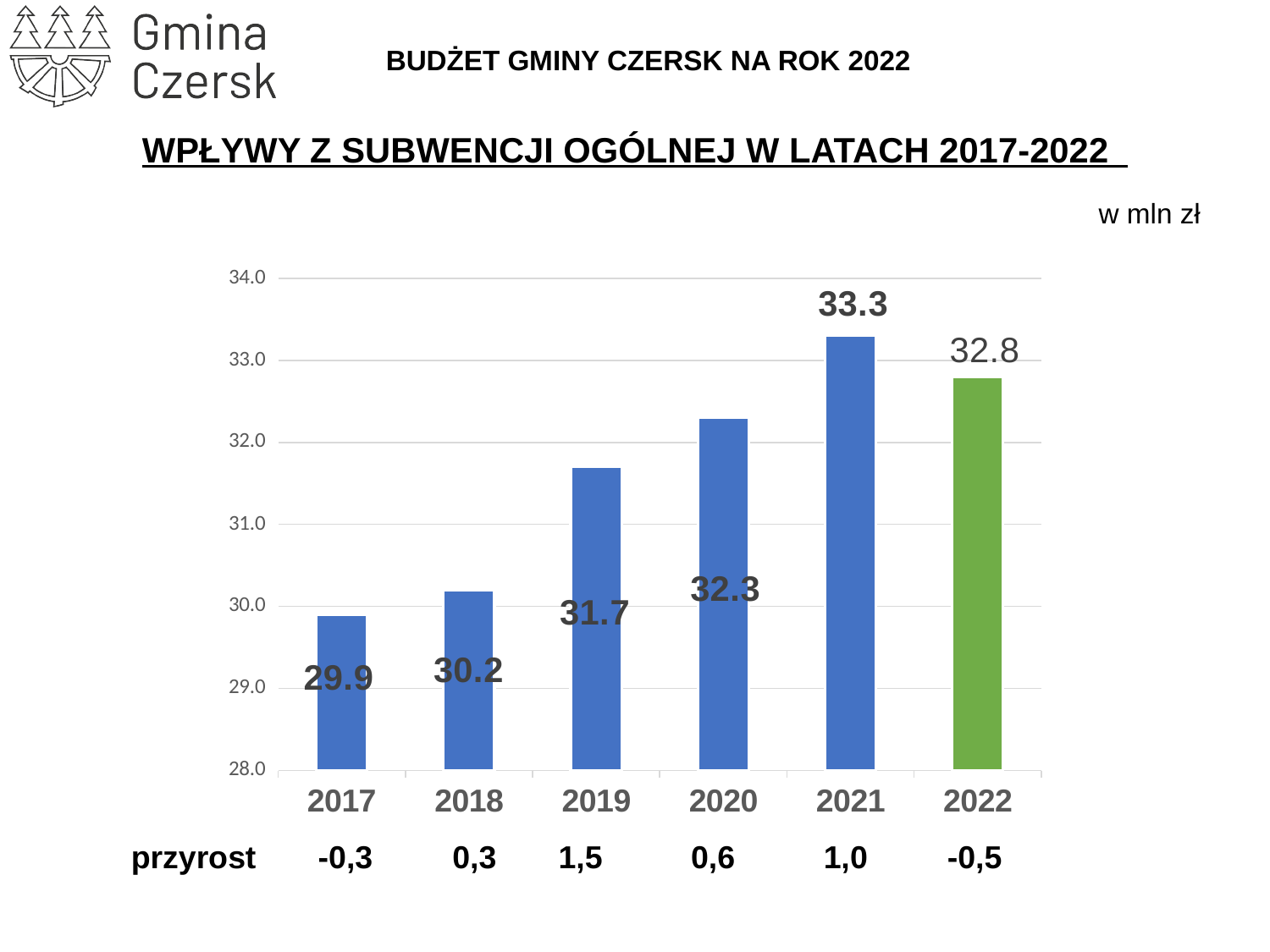
Which is larger, the value for 2020 or the value for 2022? 2022 What is the value for 2019? 31.7 Which year has the highest value? 2021 What is the value for 2022? 32.8 What kind of chart is shown on the slide? bar chart How many years are shown on the chart? 6 What is the value for 2017? 29.9 What is the difference between the values for 2021 and 2017? 3.4 Is the value for 2019 greater or less than 31.0? greater Which year has the lowest value? 2017 What is the difference between the values for 2020 and 2018? 2.1 What unit is stated for the chart values? w mln zł